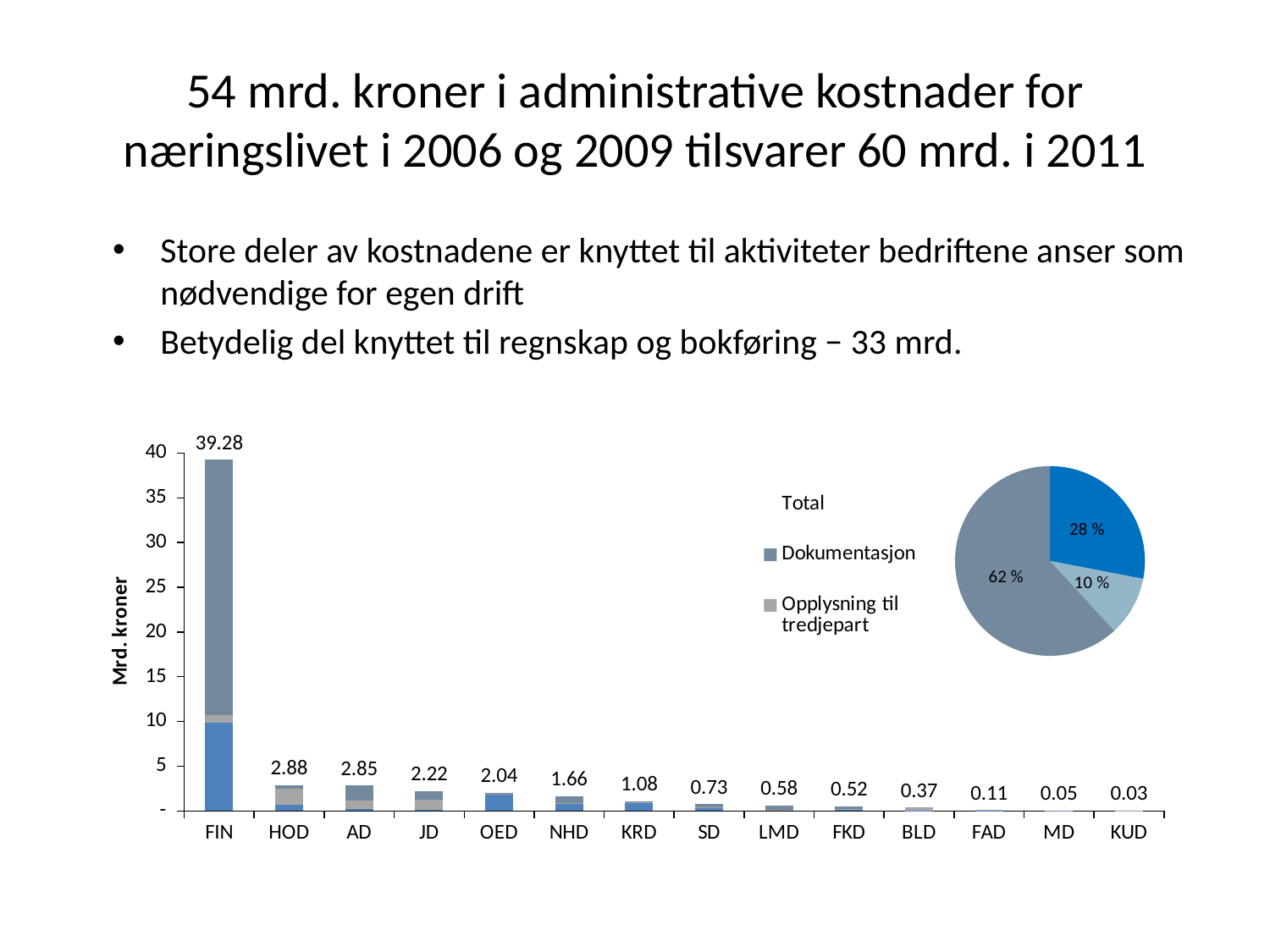
In the bar chart, which category has the lowest total? KUD In the bar chart, do the totals rise or fall from left to right along the x axis? fall In the bar chart, which category has the highest total? FIN In the bar chart, what is the difference between the totals for FIN and HOD? 36.40 In the bar chart, what is the total value labelled for FIN? 39.28 In the bar chart, is the total for FIN greater or less than 35? greater In the pie chart, what share does the largest slice have? 62 % In the bar chart, which has a larger total, JD or NHD? JD In the bar chart, what is the total value labelled for KRD? 1.08 How many categories are shown on the x axis of the bar chart? 14 What kind of chart is the chart on the left of the slide? bar chart In the bar chart, what is the total value labelled for HOD? 2.88